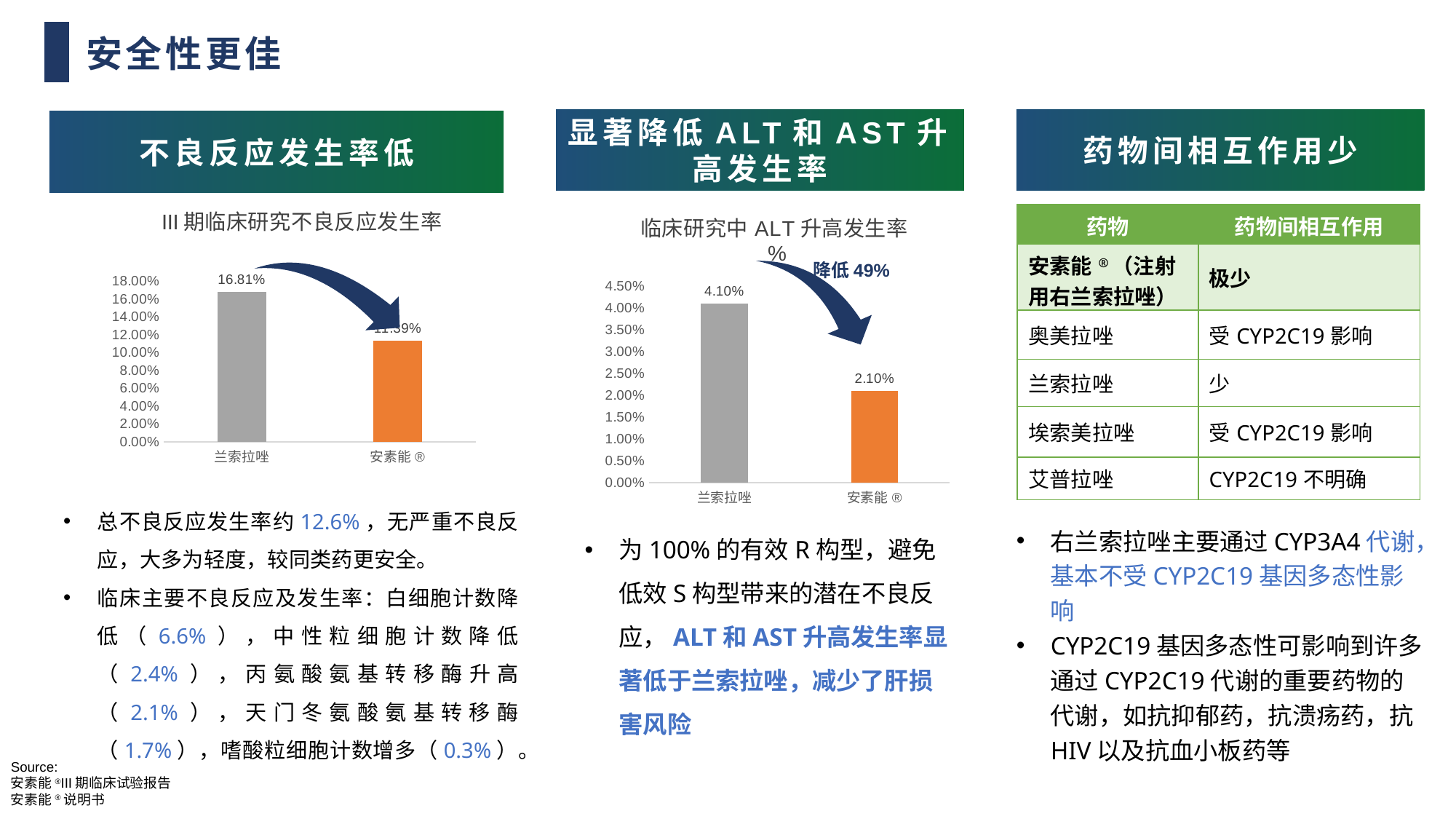
In the chart titled 'III 期临床研究不良反应发生率', what is the value for 兰索拉唑? 16.81% In the chart titled '临床研究中 ALT 升高发生率%', what is the value for 兰索拉唑? 4.10% In the chart titled '临床研究中 ALT 升高发生率%', which category has the lower value? 安素能® In the chart titled '临床研究中 ALT 升高发生率%', what colour is the bar for 安素能®? orange In the chart titled '临床研究中 ALT 升高发生率%', what is the difference between the values for 兰索拉唑 and 安素能®? 2.00% What kind of chart is the chart titled 'III 期临床研究不良反应发生率'? bar chart In the chart titled 'III 期临床研究不良反应发生率', is the value for 安素能® greater or less than 10.00%? greater In the chart titled 'III 期临床研究不良反应发生率', is the value for 安素能® greater or less than 14.00%? less How many categories are shown in the chart titled 'III 期临床研究不良反应发生率'? 2 In the chart titled '临床研究中 ALT 升高发生率%', what is the value for 安素能®? 2.10% In the chart titled '临床研究中 ALT 升高发生率%', what percentage reduction is annotated next to the arrow? 降低 49% In the chart titled 'III 期临床研究不良反应发生率', which category has the higher value? 兰索拉唑